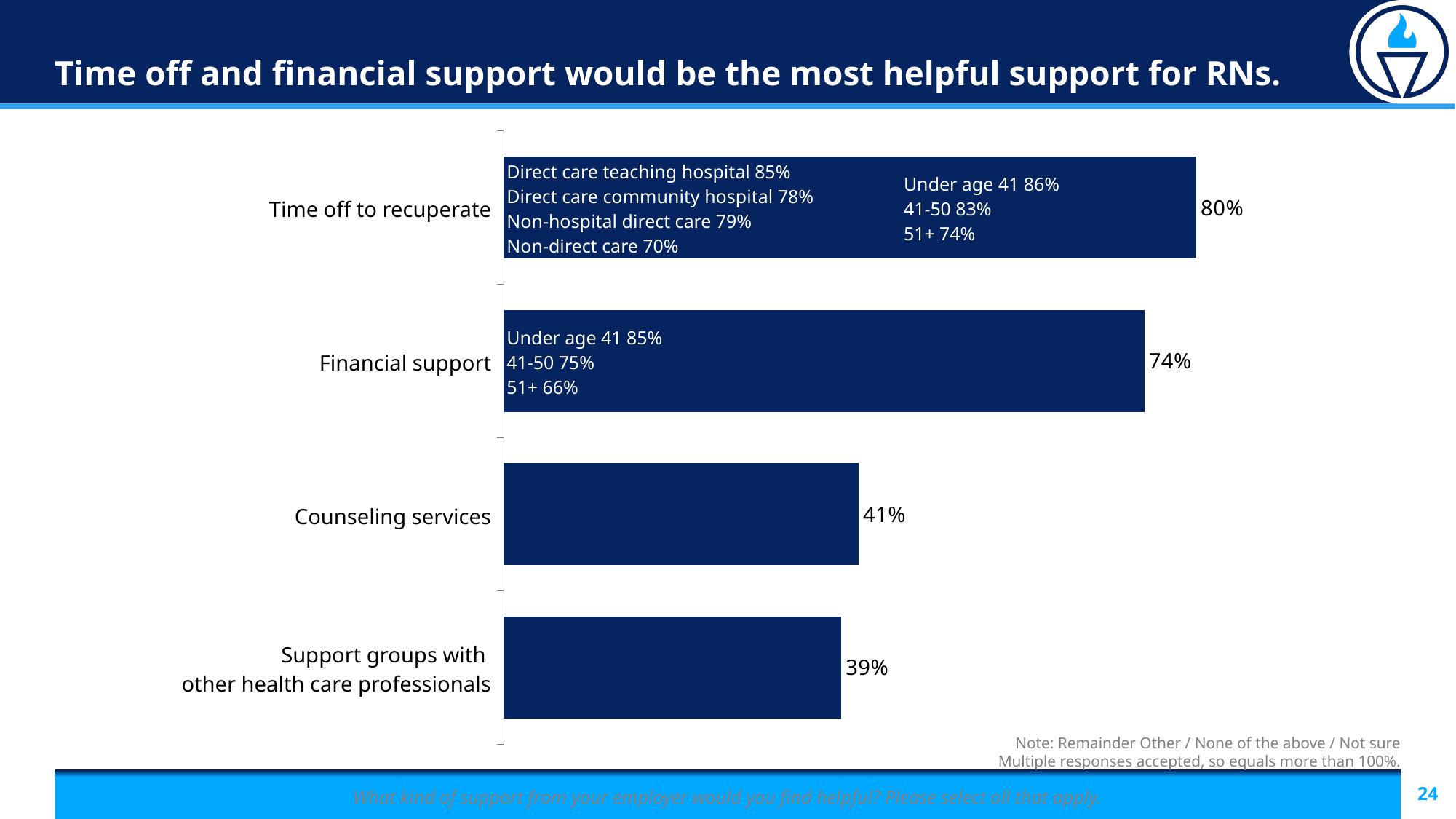
What is the value for Support groups with other health care professionals? 39% Which type of support has the lowest percentage? Support groups with other health care professionals How many types of support are shown in the chart? 4 What is the difference in percentage points between Counseling services and Support groups with other health care professionals? 2 What kind of chart is shown on the slide? Bar chart Which type of support has the highest percentage? Time off to recuperate What is the value for Counseling services? 41% What percentage of RNs said time off to recuperate would be helpful? 80% What is the difference in percentage points between Time off to recuperate and Financial support? 6 Which is larger, the value for Financial support or the value for Counseling services? Financial support According to the annotation on the Financial support bar, what percentage of RNs under age 41 found financial support helpful? 85% What is the value for Financial support? 74%